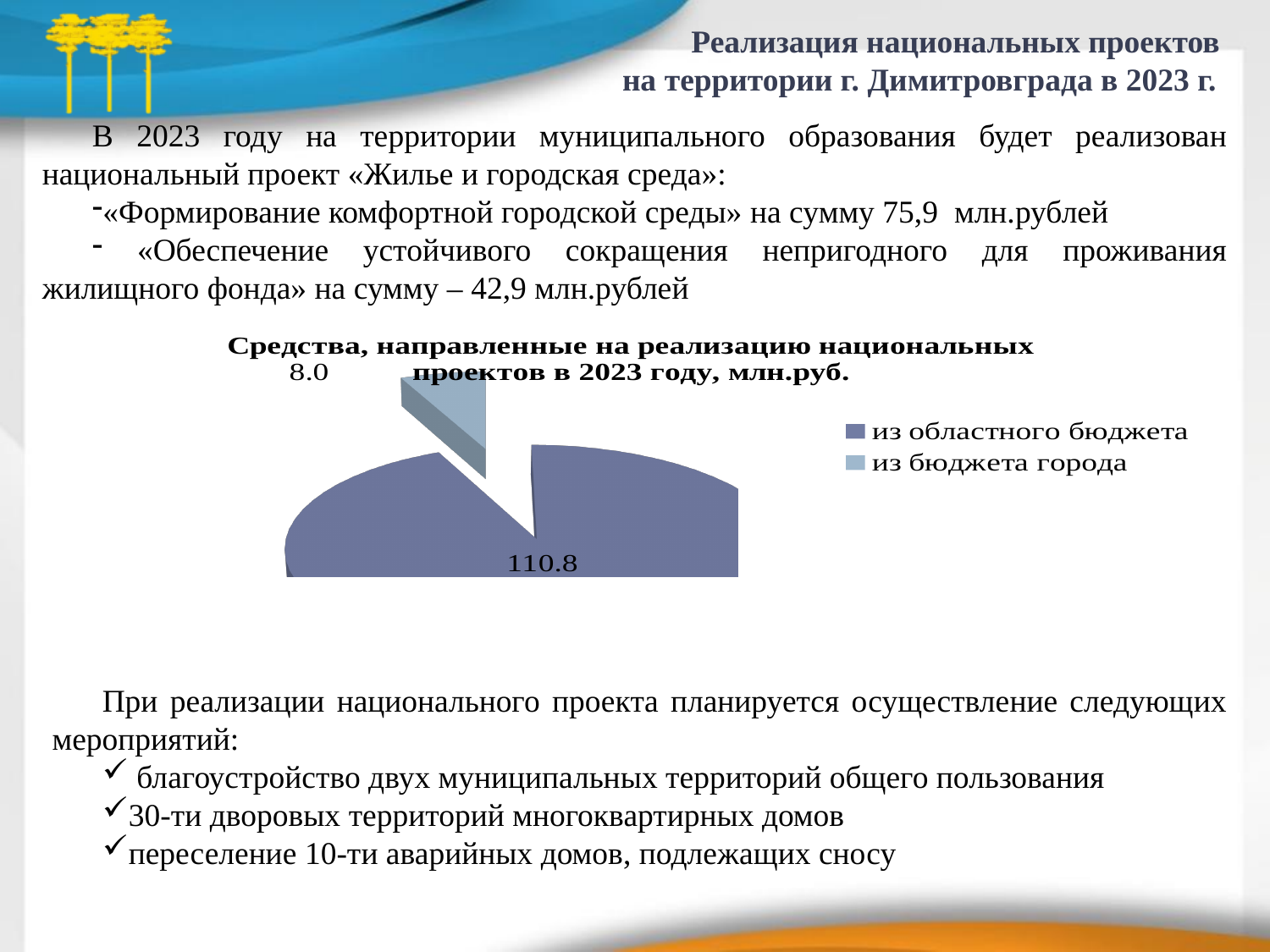
Which category has the largest slice in the pie chart? из областного бюджета What is the difference between the value for "из областного бюджета" and the value for "из бюджета города"? 102.8 What is the title of the pie chart? Средства, направленные на реализацию национальных проектов в 2023 году, млн.руб. How many entries does the legend of the pie chart list? 2 What is the value for "из бюджета города" in the pie chart? 8.0 What is the value for "из областного бюджета" in the pie chart? 110.8 Which legend entry is shown in the lighter blue colour in the pie chart? из бюджета города What is the total of all slices in the pie chart? 118.8 Which category has the smallest slice in the pie chart? из бюджета города What type of chart is shown on the slide? pie chart How many slices does the pie chart have? 2 Which is larger: the value for "из областного бюджета" or the value for "из бюджета города"? из областного бюджета